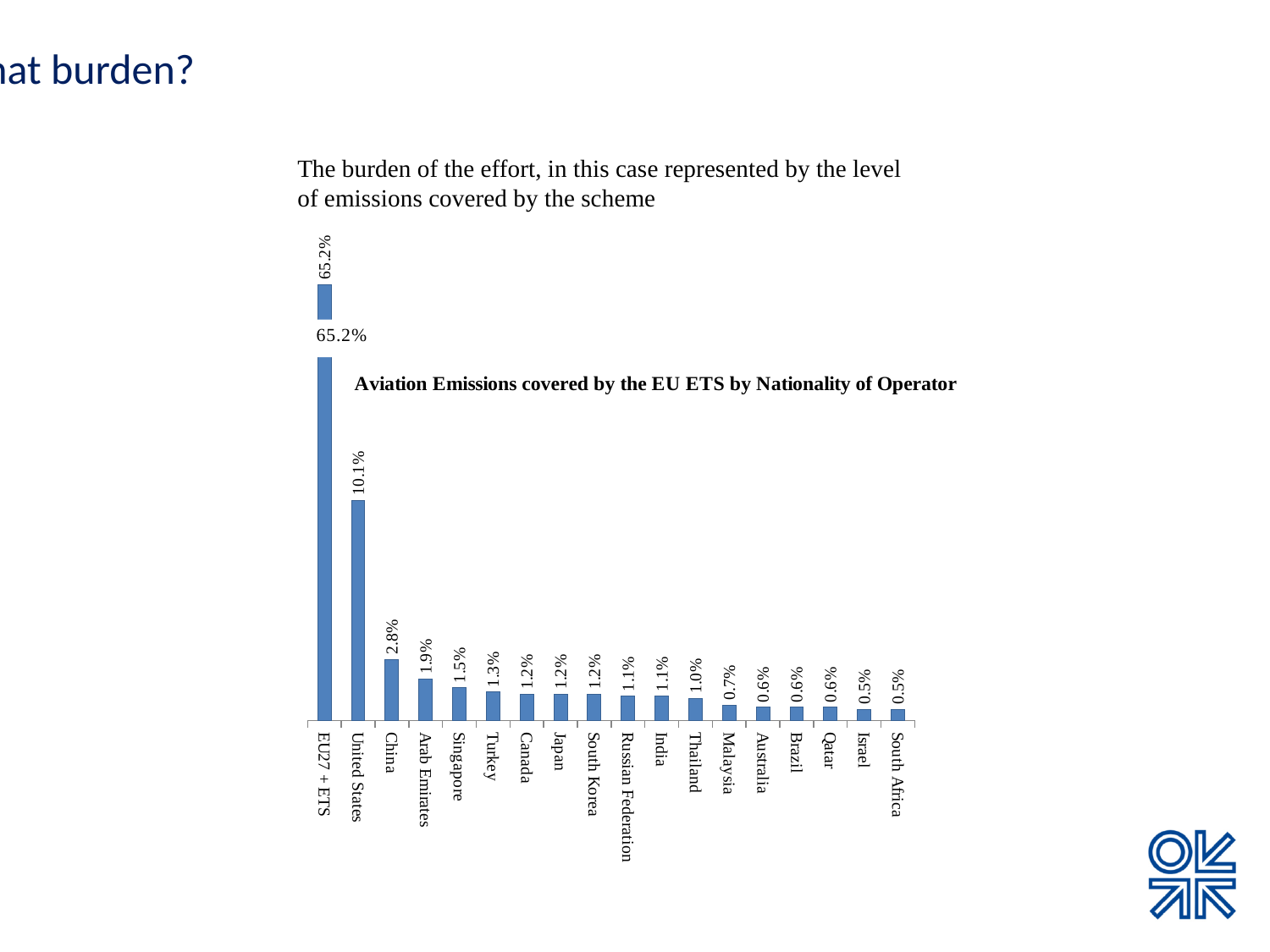
What is the value for the United States in the chart? 10.1% What kind of chart is shown on the slide? Bar chart What is the value for Malaysia in the chart? 0.7% Which has a larger value, Arab Emirates or Australia? Arab Emirates Which has a larger value, Turkey or Thailand? Turkey What is the value for Arab Emirates in the chart? 1.9% How many categories are shown in the chart? 18 What is the difference between the values for EU27 + ETS and the United States? 55.1% What is the difference between the values for China and Singapore? 1.3% What is the title of the chart? Aviation Emissions covered by the EU ETS by Nationality of Operator Which category has the highest value in the chart? EU27 + ETS What is the value for China in the chart? 2.8%